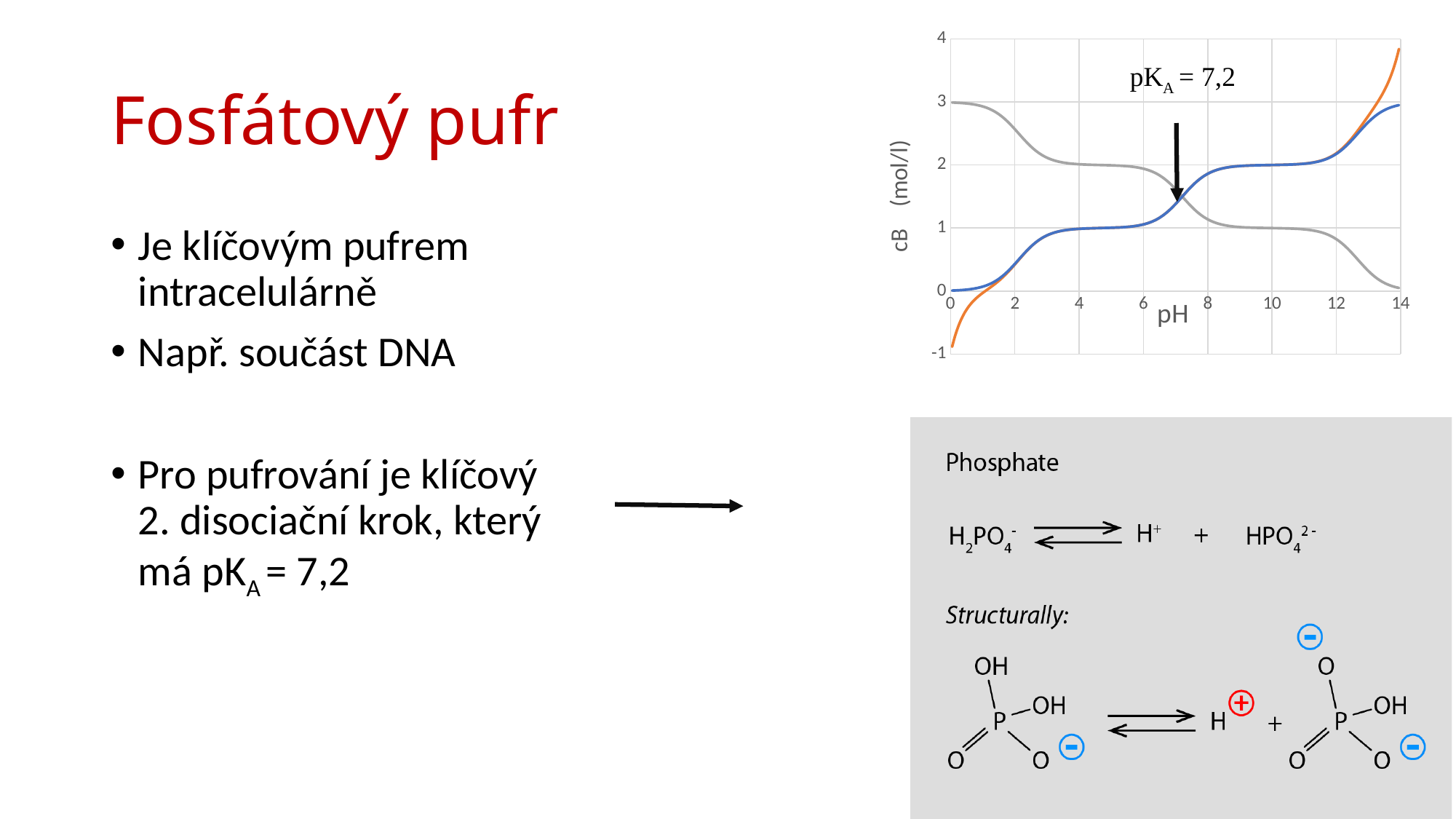
Is the value of the orange line at pH 14 greater or less than 3? greater How many lines are plotted on the chart? 3 What pKA value does the annotation on the chart point to? pKA = 7,2 Does the grey line rise or fall as pH increases from 0 to 14? fall At pH 14, which line has the higher value, the orange line or the blue line? orange line What is the label of the x axis of the chart? pH Does the blue line rise or fall as pH increases from 0 to 14? rise What kind of chart is shown on the slide? line chart What is the label of the y axis of the chart? cB (mol/l) Is the value of the blue line at pH 14 greater or less than 2? greater Is the value of the orange line at pH 0 greater or less than 0? less At pH 0, which line has the higher value, the grey line or the blue line? grey line